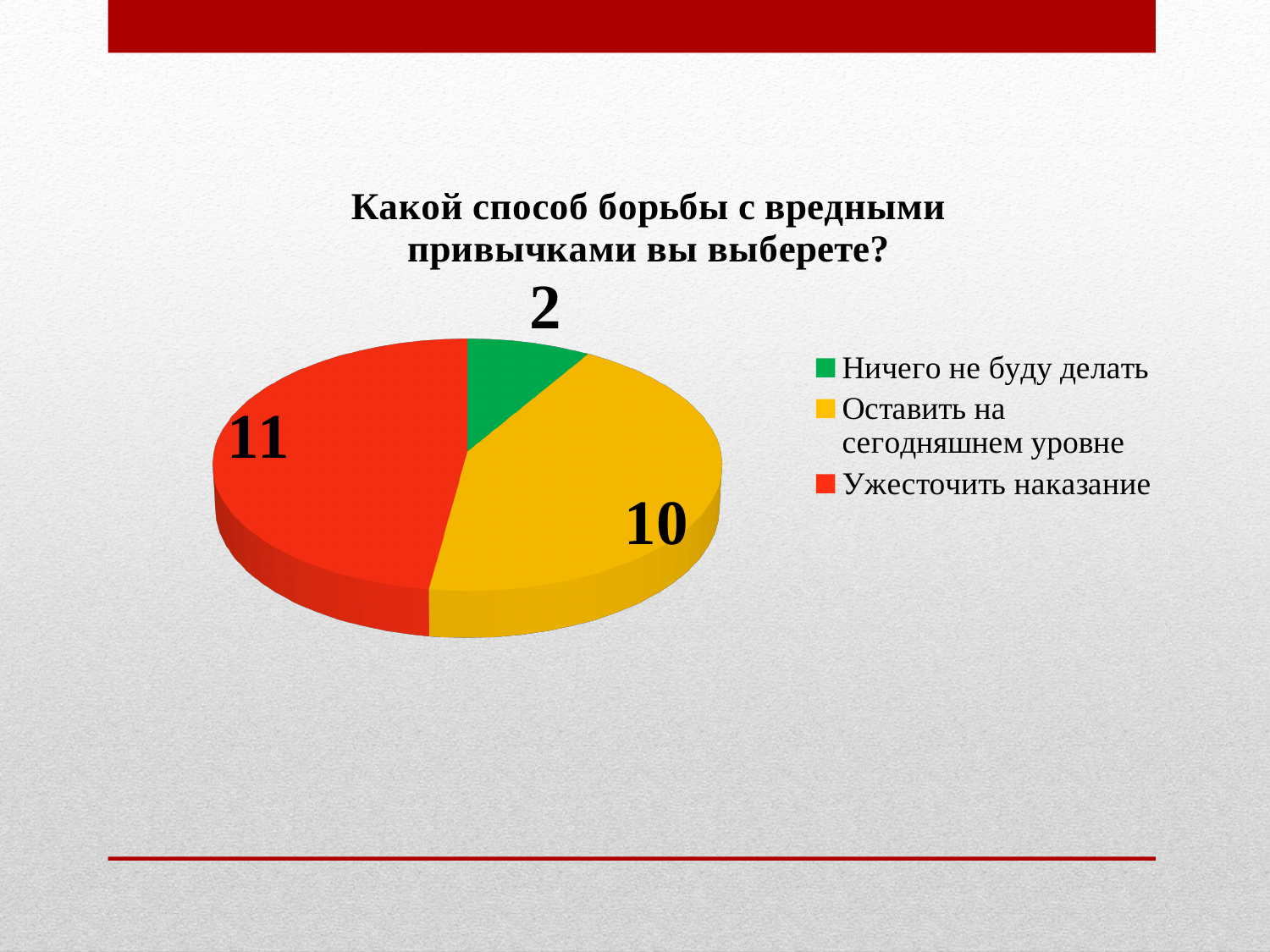
What value is shown for the slice "Ужесточить наказание"? 11 Which category has the smallest slice of the pie? Ничего не буду делать What is the difference between the values for "Ужесточить наказание" and "Оставить на сегодняшнем уровне"? 1 What value is shown for the slice "Оставить на сегодняшнем уровне"? 10 What is the difference between the values for "Оставить на сегодняшнем уровне" and "Ничего не буду делать"? 8 How many slices does the pie chart have? 3 What type of chart is shown on the slide? Pie chart What colour is the slice for "Оставить на сегодняшнем уровне"? Yellow Which is larger: the value for "Ужесточить наказание" or the value for "Ничего не буду делать"? Ужесточить наказание What value is shown for the slice "Ничего не буду делать"? 2 Which category has the largest slice of the pie? Ужесточить наказание What is the total of all the values shown on the pie chart? 23